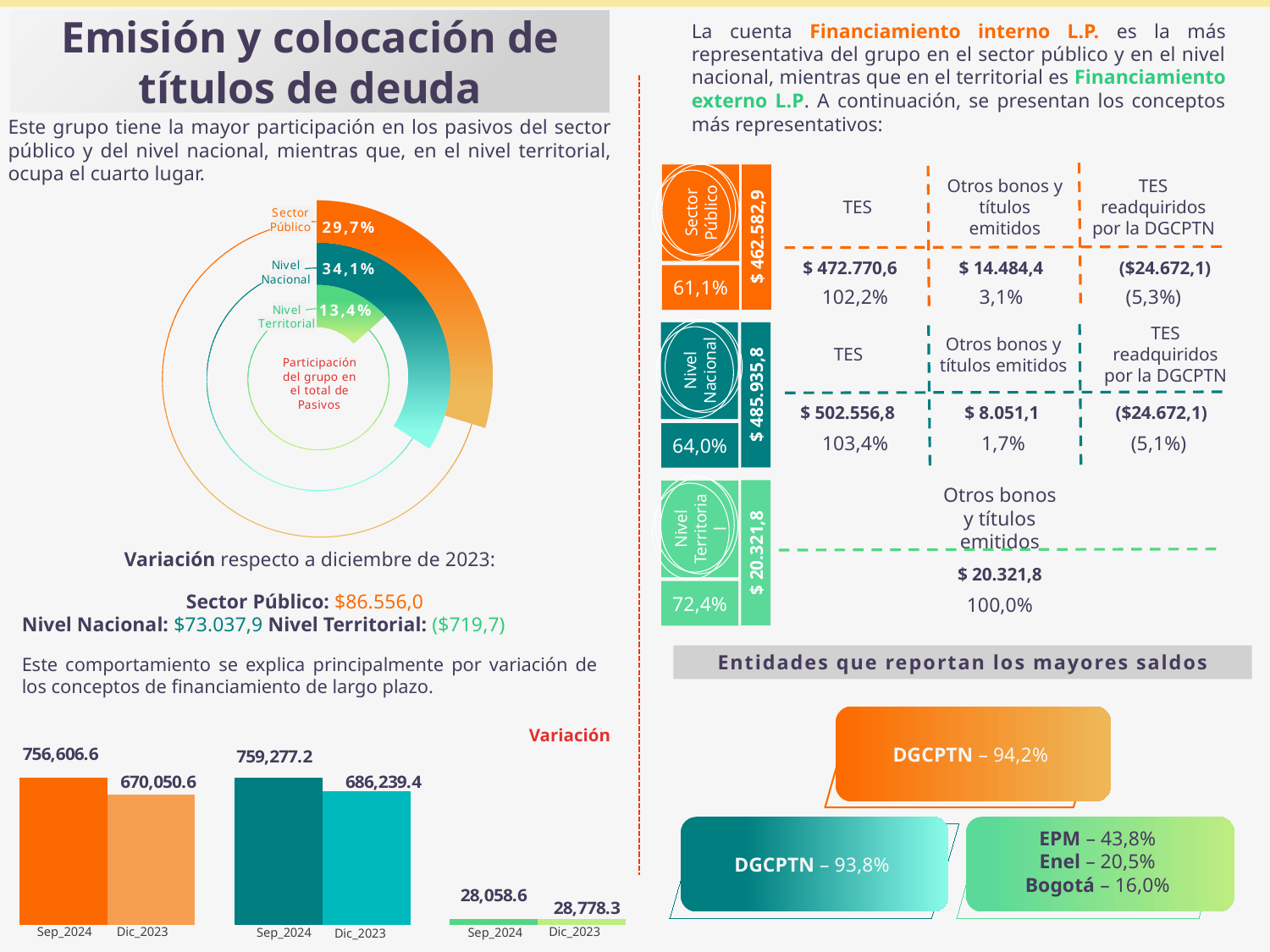
In the radial chart titled 'Participación del grupo en el total de Pasivos', which category has the lowest value? Nivel Territorial In the bar chart at the bottom of the slide, what is the Sep_2024 value in the leftmost (orange) pair of bars? 756,606.6 In the radial chart titled 'Participación del grupo en el total de Pasivos', what is the difference between the Nivel Nacional and Sector Público values? 4,4 percentage points How many bars in total are shown in the bar chart at the bottom of the slide? 6 How many categories are shown in the radial chart titled 'Participación del grupo en el total de Pasivos'? 3 In the bar chart at the bottom of the slide, in the rightmost (green) pair of bars, which is larger: Sep_2024 or Dic_2023? Dic_2023 In the radial chart titled 'Participación del grupo en el total de Pasivos', what is the value for Sector Público? 29,7% In the bar chart at the bottom of the slide, what is the difference between the Sep_2024 and Dic_2023 values in the leftmost (orange) pair of bars? 86,556.0 In the bar chart at the bottom of the slide, what is the Dic_2023 value in the middle (teal) pair of bars? 686,239.4 What kind of chart is shown at the bottom left of the slide, with Sep_2024 and Dic_2023 values? Bar chart In the radial chart titled 'Participación del grupo en el total de Pasivos', what is the value for Nivel Nacional? 34,1% In the radial chart titled 'Participación del grupo en el total de Pasivos', which category has the highest value? Nivel Nacional